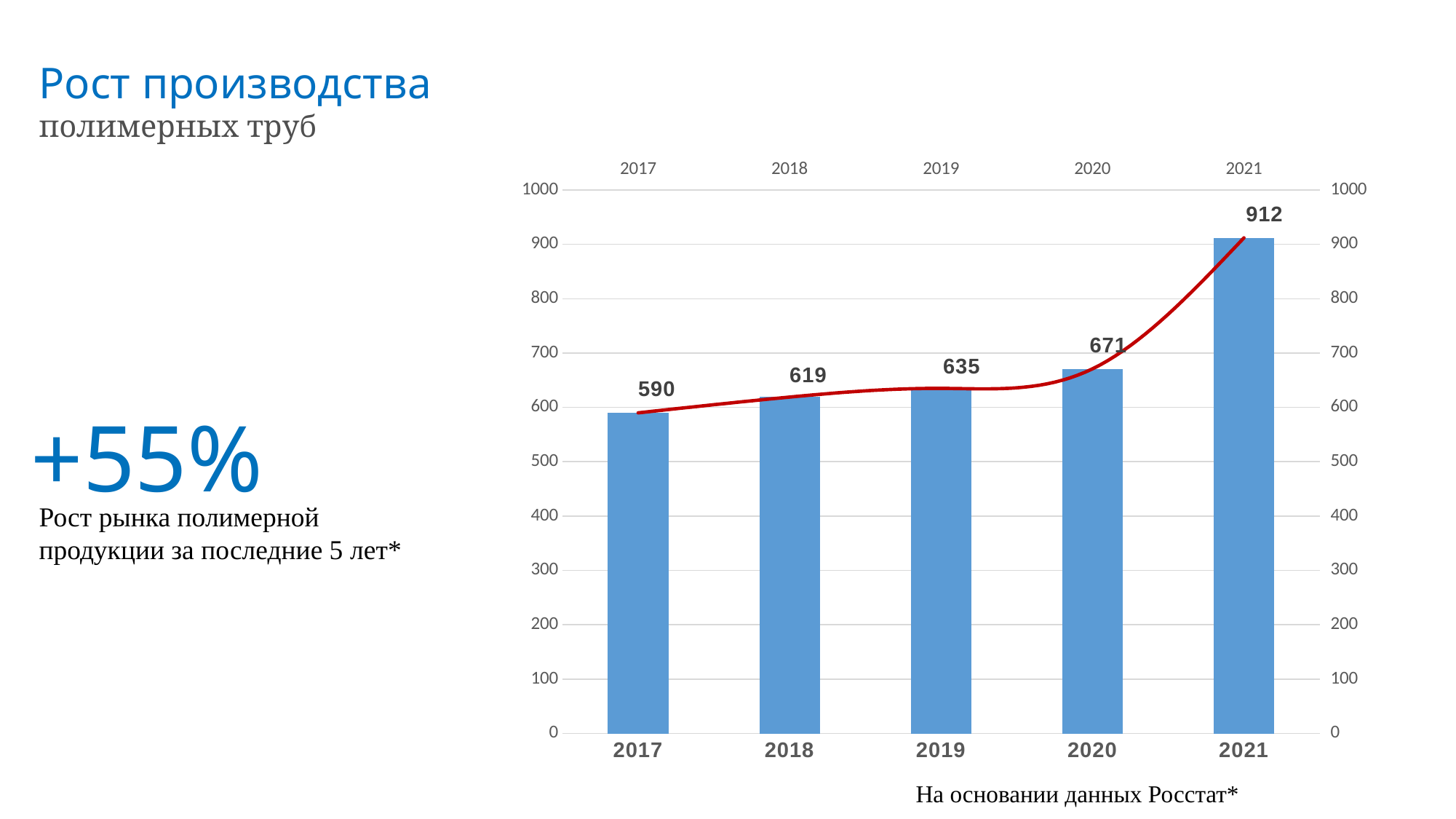
Which year has the highest value? 2021 Which year has the lowest value? 2017 What is the value for 2021? 912 Which is larger, the value for 2019 or the value for 2020? 2020 What is the value for 2019? 635 What is the value for 2017? 590 What is the difference between the values for 2018 and 2017? 29 Do the values rise or fall from 2017 to 2021? rise What is the difference between the values for 2021 and 2020? 241 How many years are shown on the x axis? 5 What kind of chart is this? combination bar and line chart Is the value for 2020 greater or less than 700? less